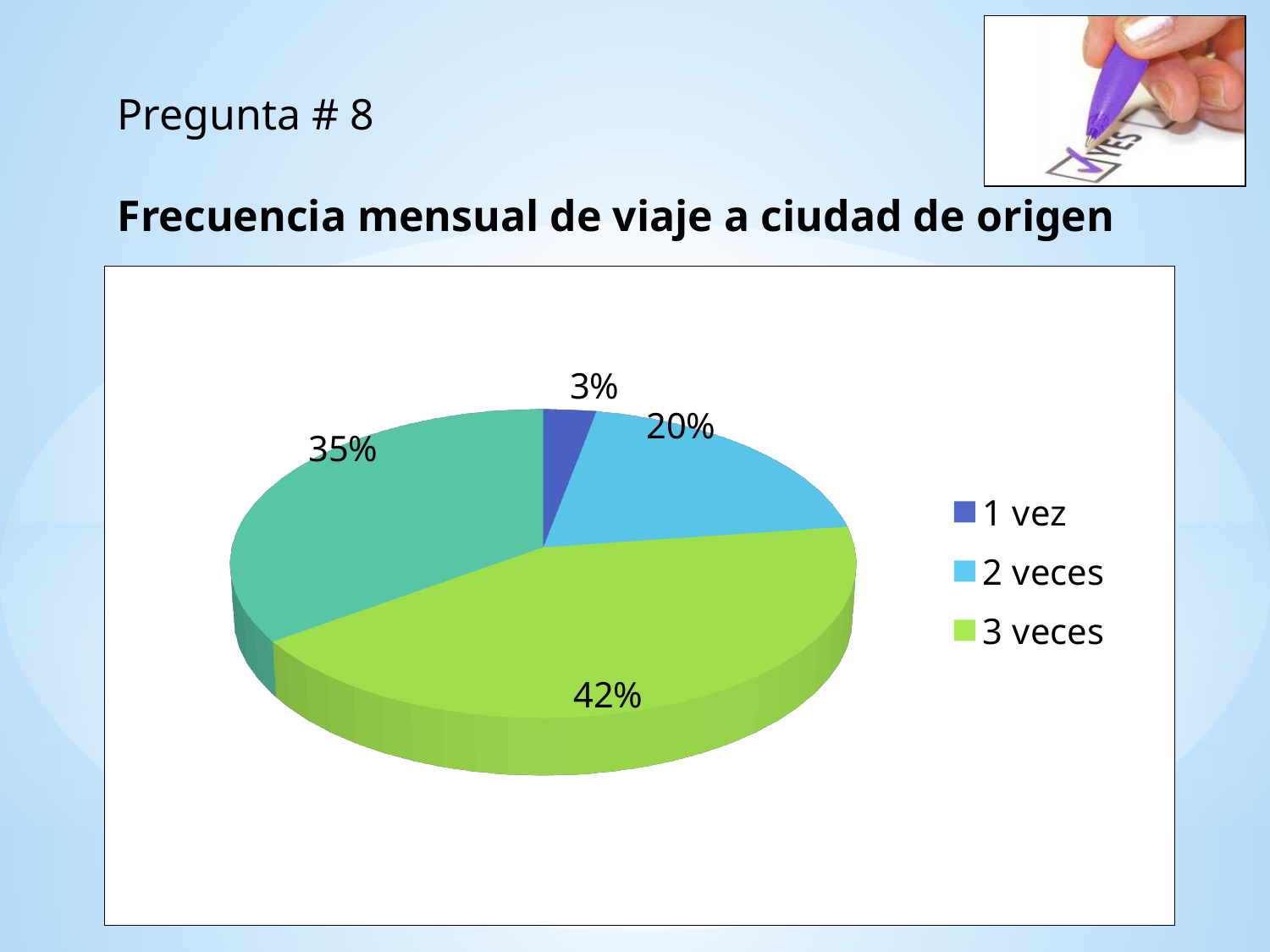
Which slice is larger, '2 veces' or '1 vez'? 2 veces What is the title shown above the chart? Frecuencia mensual de viaje a ciudad de origen What is the difference in percentage points between the '3 veces' slice and the '2 veces' slice? 22 What kind of chart is shown on the slide? pie chart What is the difference in percentage points between the '2 veces' slice and the '1 vez' slice? 17 What percentage is shown for the '2 veces' slice? 20% What percentage is shown for the '1 vez' slice? 3% What percentage is shown for the '3 veces' slice? 42% Which legend category has the largest slice of the pie? 3 veces How many slices does the pie chart have? 4 How many entries does the legend list? 3 Which legend category has the smallest slice of the pie? 1 vez